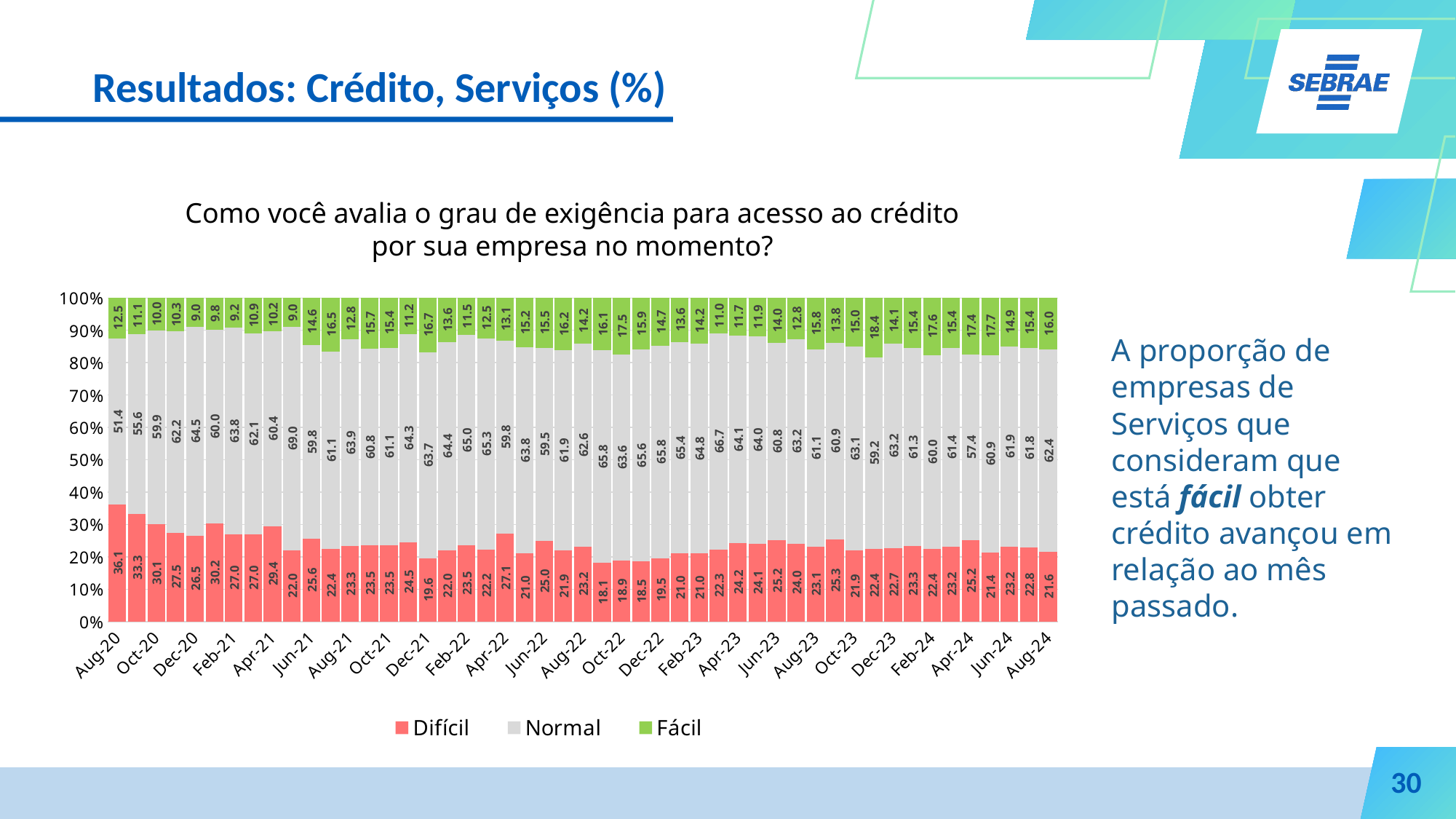
Which colour represents the Fácil series in the legend? Green What is the Normal value for Dec-22? 65.8 What is the Fácil value for Feb-24? 17.6 How many series does the legend list? 3 What is the Difícil value for Aug-20? 36.1 Does the Difícil value rise or fall overall from Aug-20 to Aug-24? Fall Which is larger, the Fácil value for Aug-20 or the Fácil value for Dec-20? Aug-20 Which month has the highest Difícil value? Aug-20 What is the Fácil value for Aug-24? 16.0 What is the difference between the Fácil value for Aug-24 and the Fácil value for Aug-20? 3.5 What kind of chart is shown on the slide? Stacked bar chart What is the difference between the Difícil value for Aug-20 and the Difícil value for Aug-24? 14.5